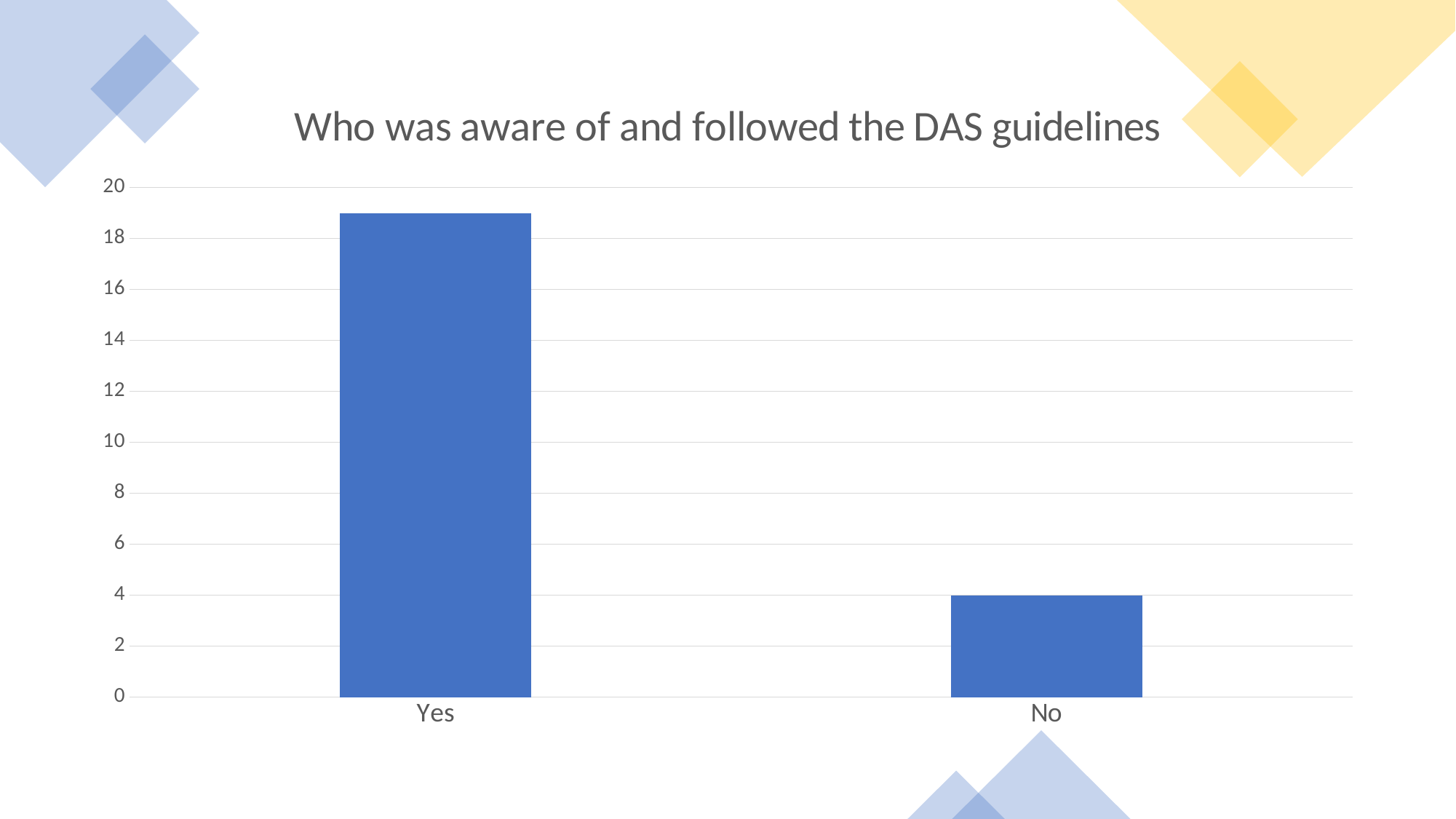
What is the value for the "No" category? 4 What is the title of the chart? Who was aware of and followed the DAS guidelines Which is larger, the value for "Yes" or the value for "No"? Yes Do the values rise or fall from "Yes" to "No" along the x axis? fall How many categories are shown on the x axis of the chart? 2 Which category has the lowest value? No What type of chart is shown on the slide? bar chart Is the value for "Yes" greater or less than 18? greater What is the maximum value shown on the y axis? 20 Which category has the highest value? Yes Is the value for "No" greater or less than 10? less Is the value for "Yes" greater or less than 20? less